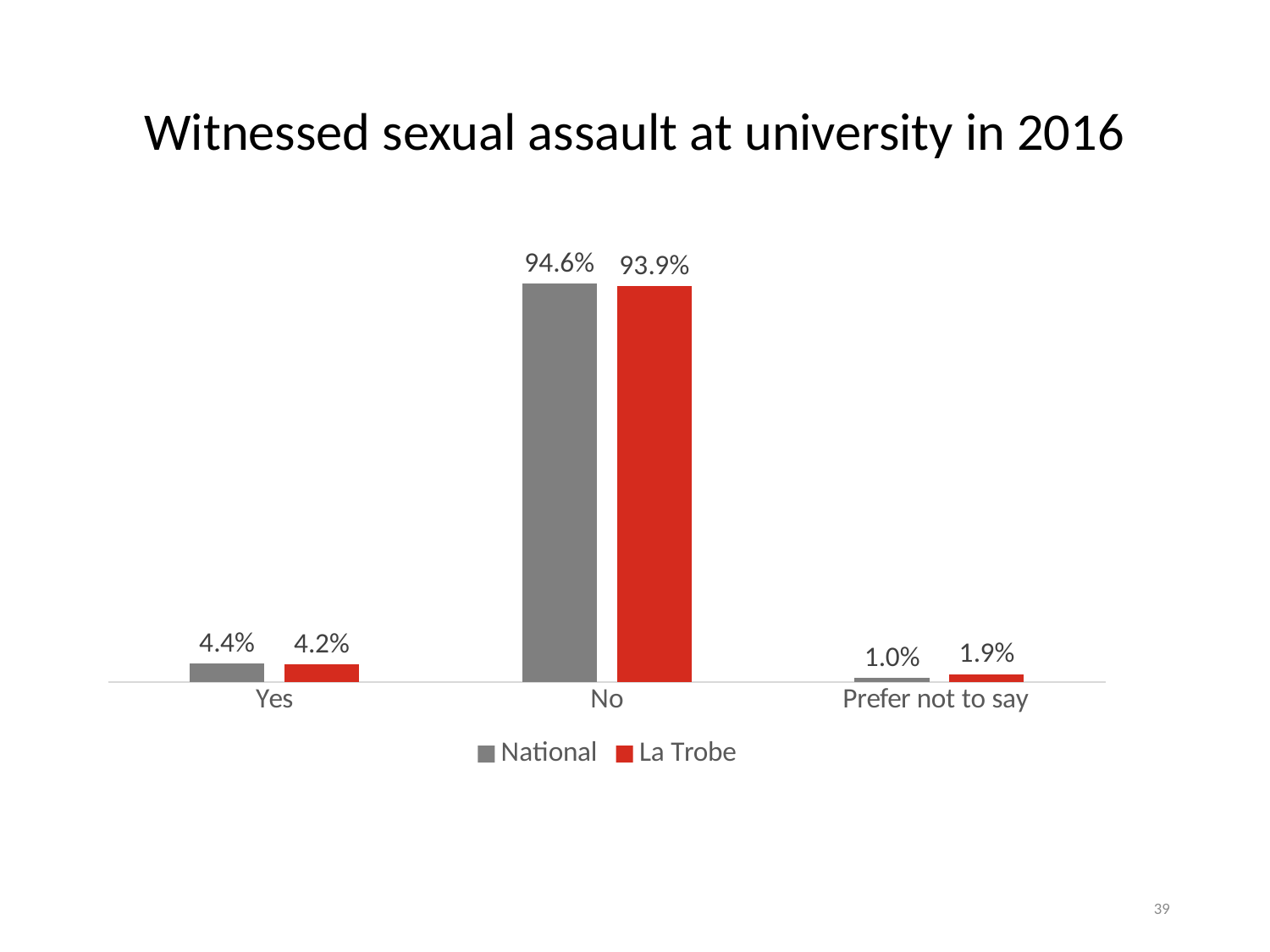
How many series does the legend list? 2 What is the difference between the National and La Trobe values for "No"? 0.7% What is the La Trobe value for "Yes"? 4.2% What is the National value for "No"? 94.6% How many categories are shown on the x axis? 3 For "Prefer not to say", which series has the larger value, National or La Trobe? La Trobe What is the La Trobe value for "Prefer not to say"? 1.9% What is the difference between the La Trobe and National values for "Prefer not to say"? 0.9% Which category has the highest National value? No What kind of chart is shown on the slide? Bar chart What is the National value for "Prefer not to say"? 1.0% Which category has the lowest La Trobe value? Prefer not to say